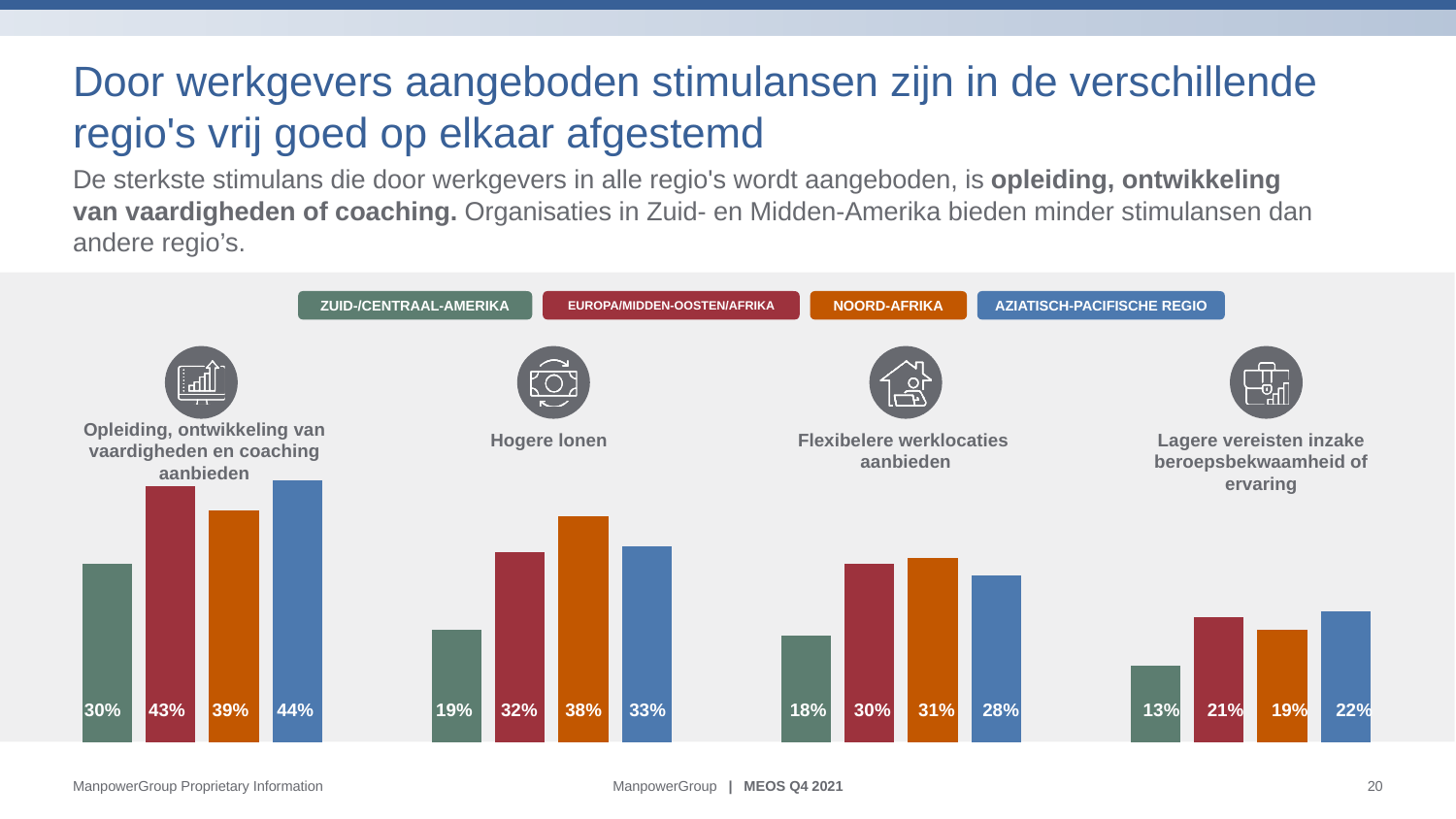
In the 'Flexibelere werklocaties aanbieden' chart, what is the value for Europa/Midden-Oosten/Afrika? 30% In the 'Opleiding, ontwikkeling van vaardigheden en coaching aanbieden' chart, what is the value for Zuid-/Centraal-Amerika? 30% In the 'Hogere lonen' chart, which region has the lowest value? Zuid-/Centraal-Amerika In the 'Flexibelere werklocaties aanbieden' chart, which is larger: the value for Aziatisch-Pacifische regio or the value for Zuid-/Centraal-Amerika? Aziatisch-Pacifische regio In the 'Hogere lonen' chart, what is the difference between Noord-Afrika and Zuid-/Centraal-Amerika? 19% How many regions does the legend list? 4 In the 'Lagere vereisten inzake beroepsbekwaamheid of ervaring' chart, what is the value for Aziatisch-Pacifische regio? 22% In the 'Lagere vereisten inzake beroepsbekwaamheid of ervaring' chart, which region has the lowest value? Zuid-/Centraal-Amerika In the 'Hogere lonen' chart, what is the value for Noord-Afrika? 38% What kind of chart is used for 'Hogere lonen'? Bar chart In the 'Opleiding, ontwikkeling van vaardigheden en coaching aanbieden' chart, which region has the highest value? Aziatisch-Pacifische regio In the 'Lagere vereisten inzake beroepsbekwaamheid of ervaring' chart, what is the difference between Europa/Midden-Oosten/Afrika and Noord-Afrika? 2%